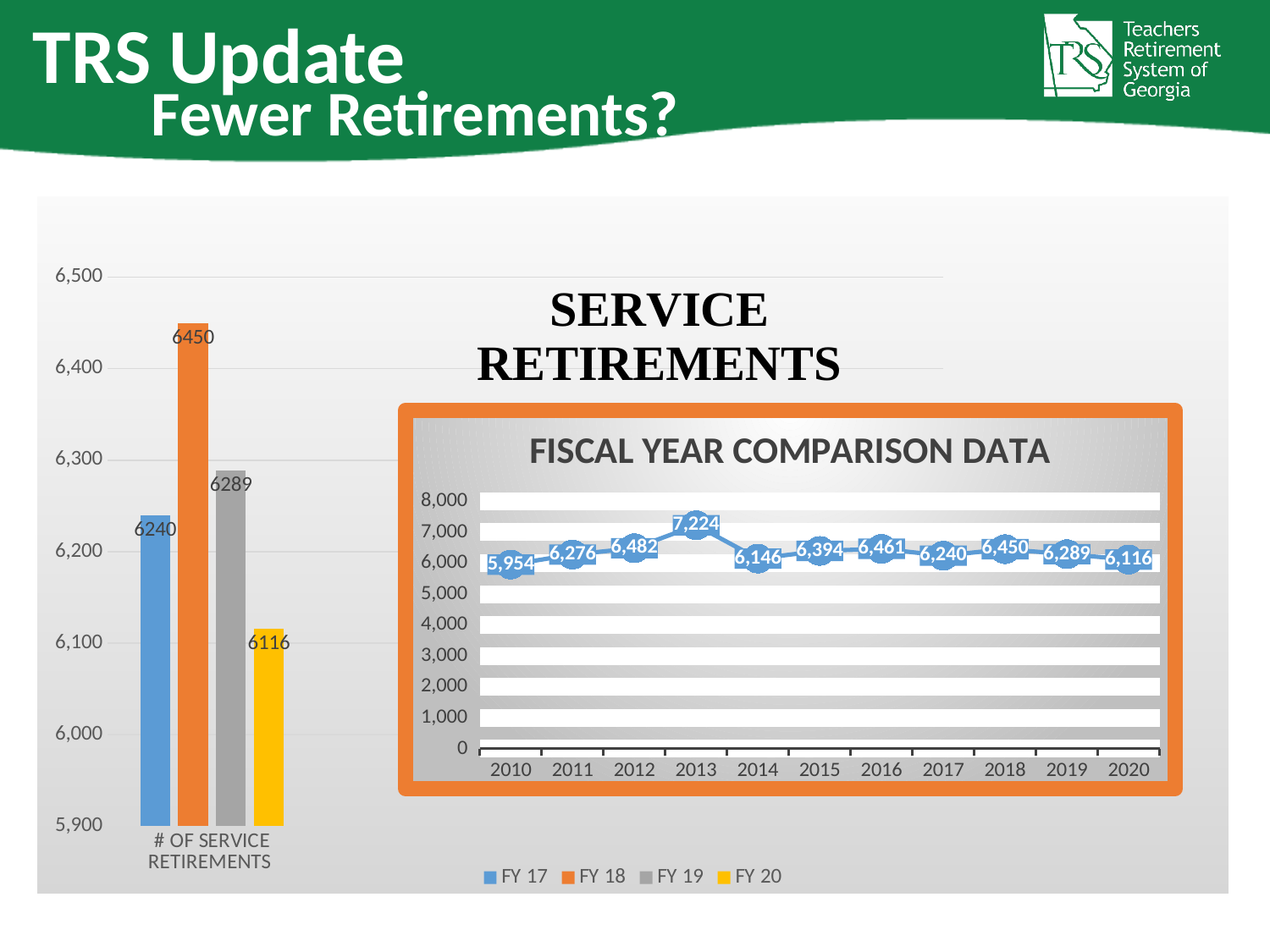
In the Fiscal Year Comparison Data chart, how many years are plotted on the x axis? 11 In the bar chart on the left, which fiscal year has the lowest number of service retirements? FY 20 In the bar chart on the left, what is the value for FY 20? 6116 What kind of chart is the Fiscal Year Comparison Data chart? Line chart In the bar chart on the left, what is the value for FY 18? 6450 In the bar chart on the left, what is the difference between the FY 18 and FY 20 values? 334 In the Fiscal Year Comparison Data chart, which year has the highest value? 2013 In the bar chart on the left, which fiscal year has the highest number of service retirements? FY 18 In the Fiscal Year Comparison Data chart, which year has the lowest value? 2010 In the Fiscal Year Comparison Data chart, what is the value for 2013? 7,224 In the Fiscal Year Comparison Data chart, what is the value for 2010? 5,954 In the bar chart on the left, how many series does the legend list? 4